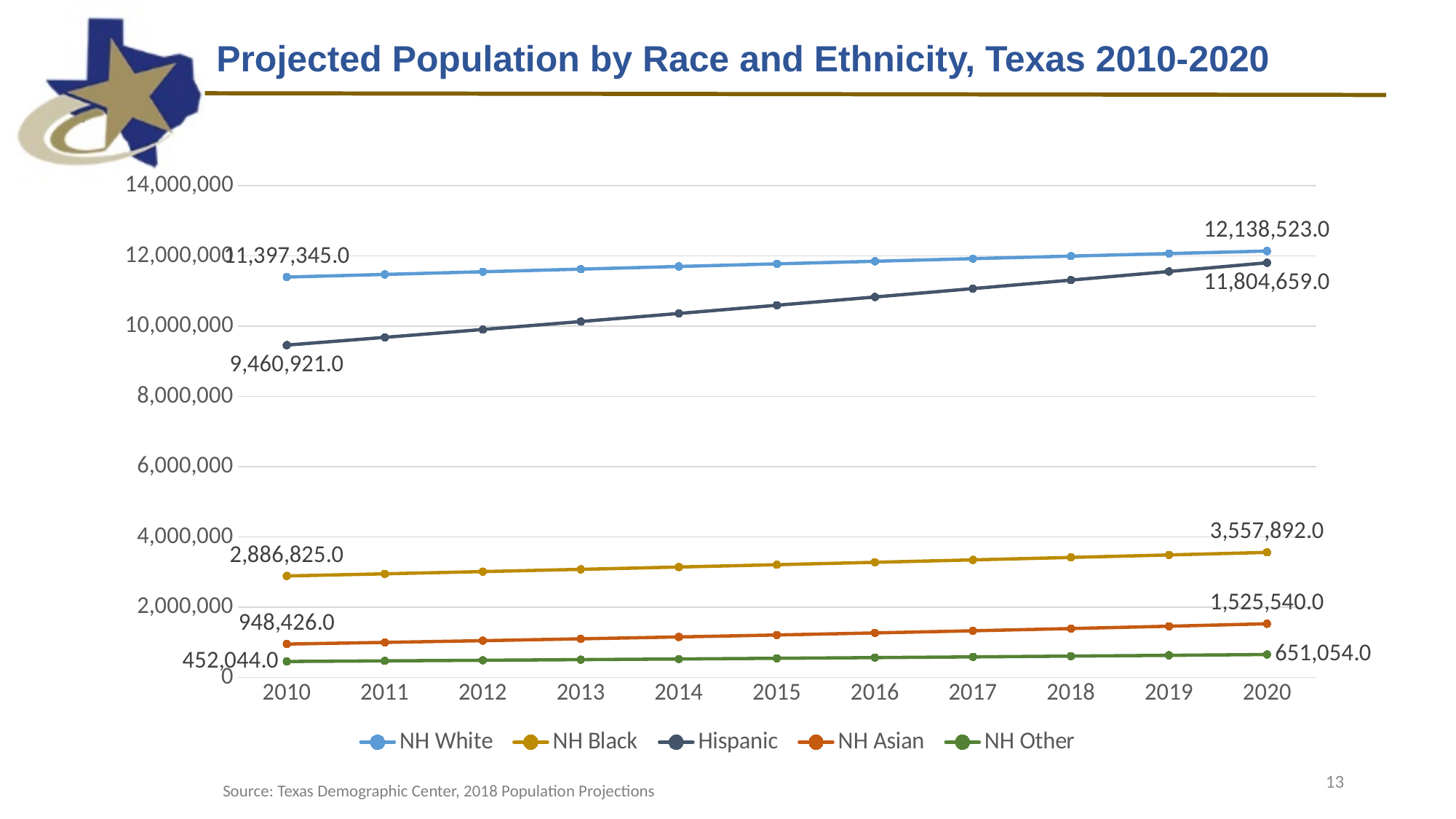
What is the projected NH Asian population in 2010? 948,426.0 What is the projected NH White population in 2020? 12,138,523.0 What is the projected NH Black population in 2020? 3,557,892.0 What is the projected Hispanic population in 2010? 9,460,921.0 Is the Hispanic population in 2015 greater or less than 10,000,000? greater Which series has the lowest projected population in 2020? NH Other Does the NH Asian population rise or fall from 2010 to 2020? rise How many years are shown on the x axis? 11 By how much does the Hispanic population increase from 2010 to 2020? 2,343,738.0 How many series does the legend list? 5 What type of chart is shown on the slide? line chart What is the projected NH Other population in 2020? 651,054.0